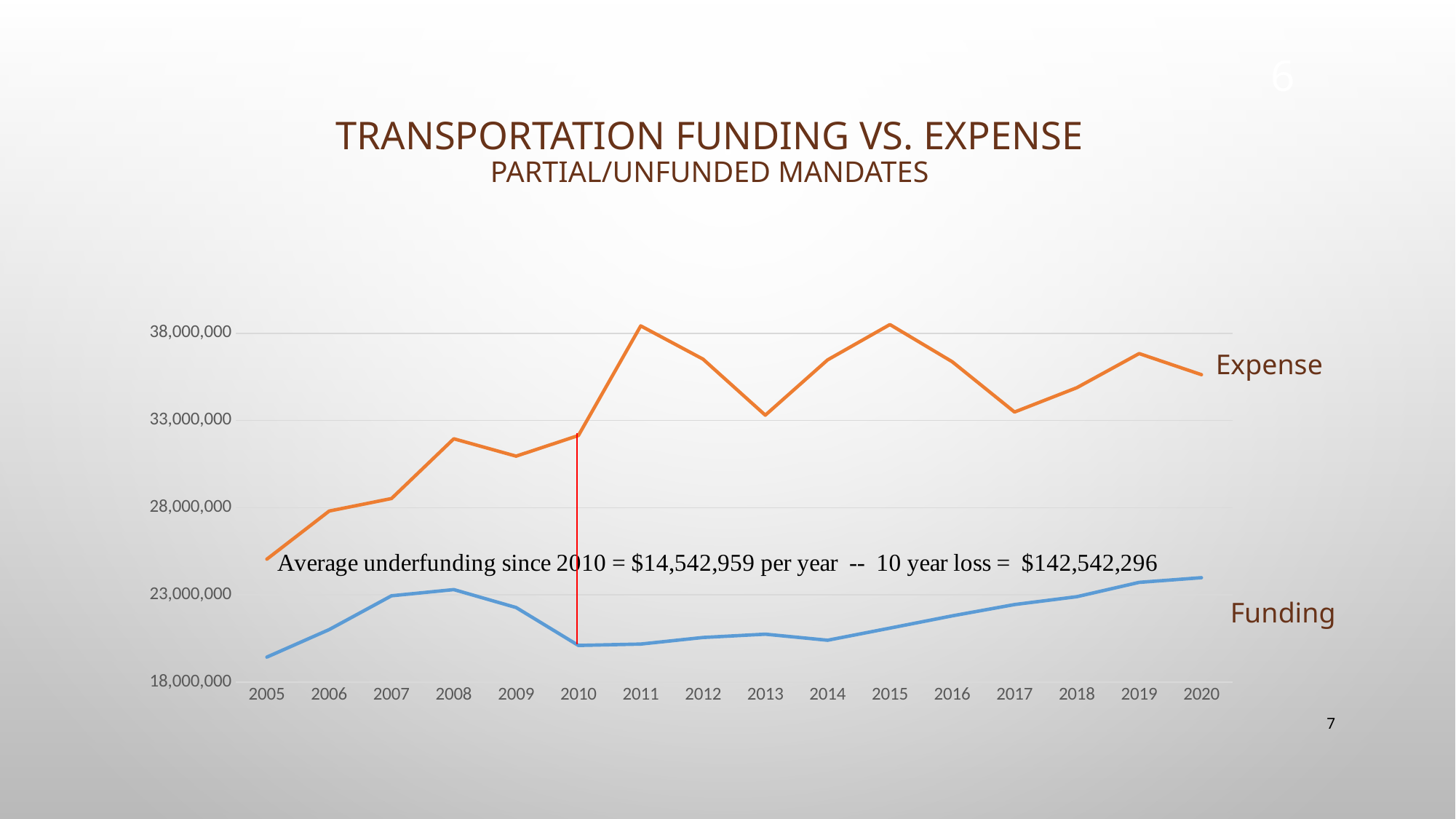
Does the Funding line rise or fall from 2010 to 2020? Rise In which year is the Expense line at its lowest? 2005 Is the Expense value for 2005 greater or less than 28,000,000? less Which is larger in 2015, Expense or Funding? Expense What kind of chart is shown on the slide? Line chart According to the annotation on the chart, what is the average underfunding per year since 2010? $14,542,959 What is the title of the chart on the slide? Transportation Funding vs. Expense Is the Expense value for 2011 greater or less than 38,000,000? greater How many years are shown along the x axis of the chart? 16 Is the Expense value for 2008 greater or less than 33,000,000? less How many series are plotted on the chart? 2